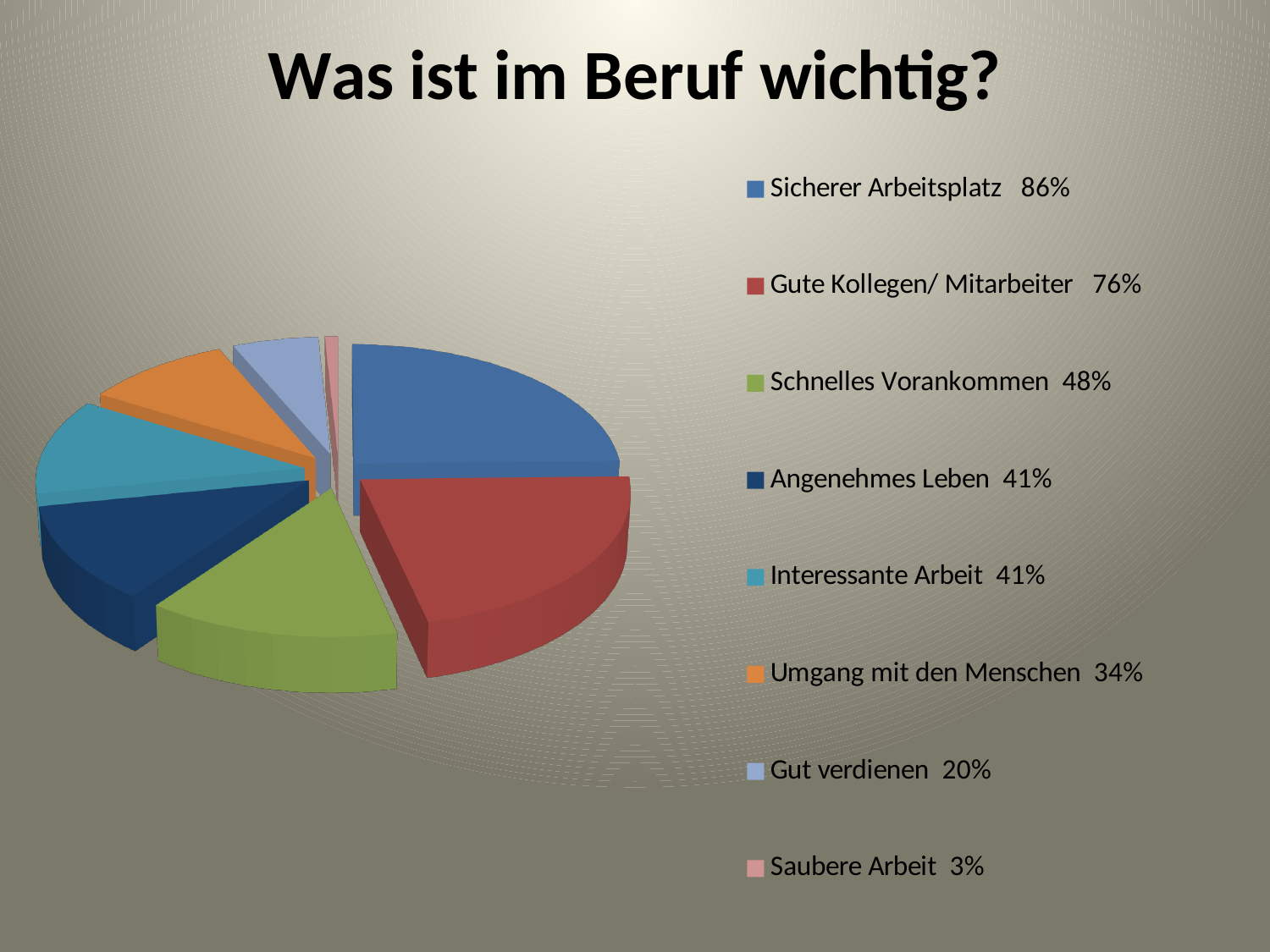
Which category has the lowest percentage? Saubere Arbeit What percentage is shown for Umgang mit den Menschen? 34% What kind of chart is shown on the slide? pie chart How many categories does the legend list? 8 What is the title of the chart on the slide? Was ist im Beruf wichtig? Which has a higher percentage, Schnelles Vorankommen or Umgang mit den Menschen? Schnelles Vorankommen What percentage is shown for Schnelles Vorankommen? 48% What percentage is shown for Gute Kollegen/ Mitarbeiter? 76% Which category has the highest percentage? Sicherer Arbeitsplatz What is the difference between the percentages for Sicherer Arbeitsplatz and Gute Kollegen/ Mitarbeiter? 10% What percentage is shown for Gut verdienen? 20% What percentage is shown for Sicherer Arbeitsplatz? 86%